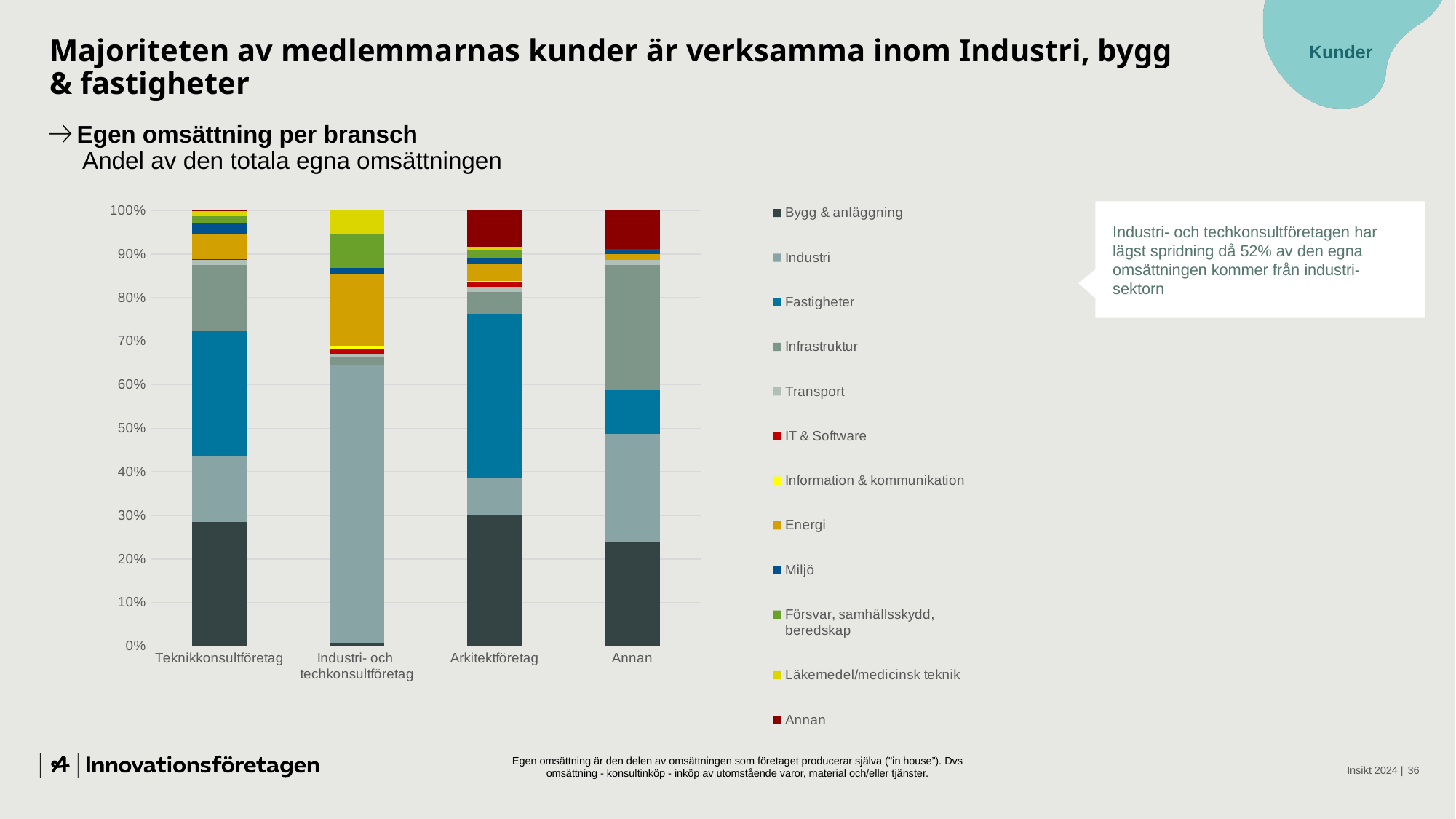
How many categories are shown on the x axis of the chart? 4 How many series does the chart's legend list? 12 Which is larger: the Industri segment for Industri- och techkonsultföretag or the Industri segment for Arkitektföretag? Industri- och techkonsultföretag Which category has the largest Industri segment? Industri- och techkonsultföretag Is the Industri share for Industri- och techkonsultföretag greater or less than 60%? greater Is the Bygg & anläggning share for Teknikkonsultföretag greater or less than 20%? greater Which category has the smallest Bygg & anläggning segment? Industri- och techkonsultföretag What is the title of the chart? Egen omsättning per bransch Is the Fastigheter share for Arkitektföretag greater or less than 30%? greater What kind of chart is shown on the slide? Stacked bar chart